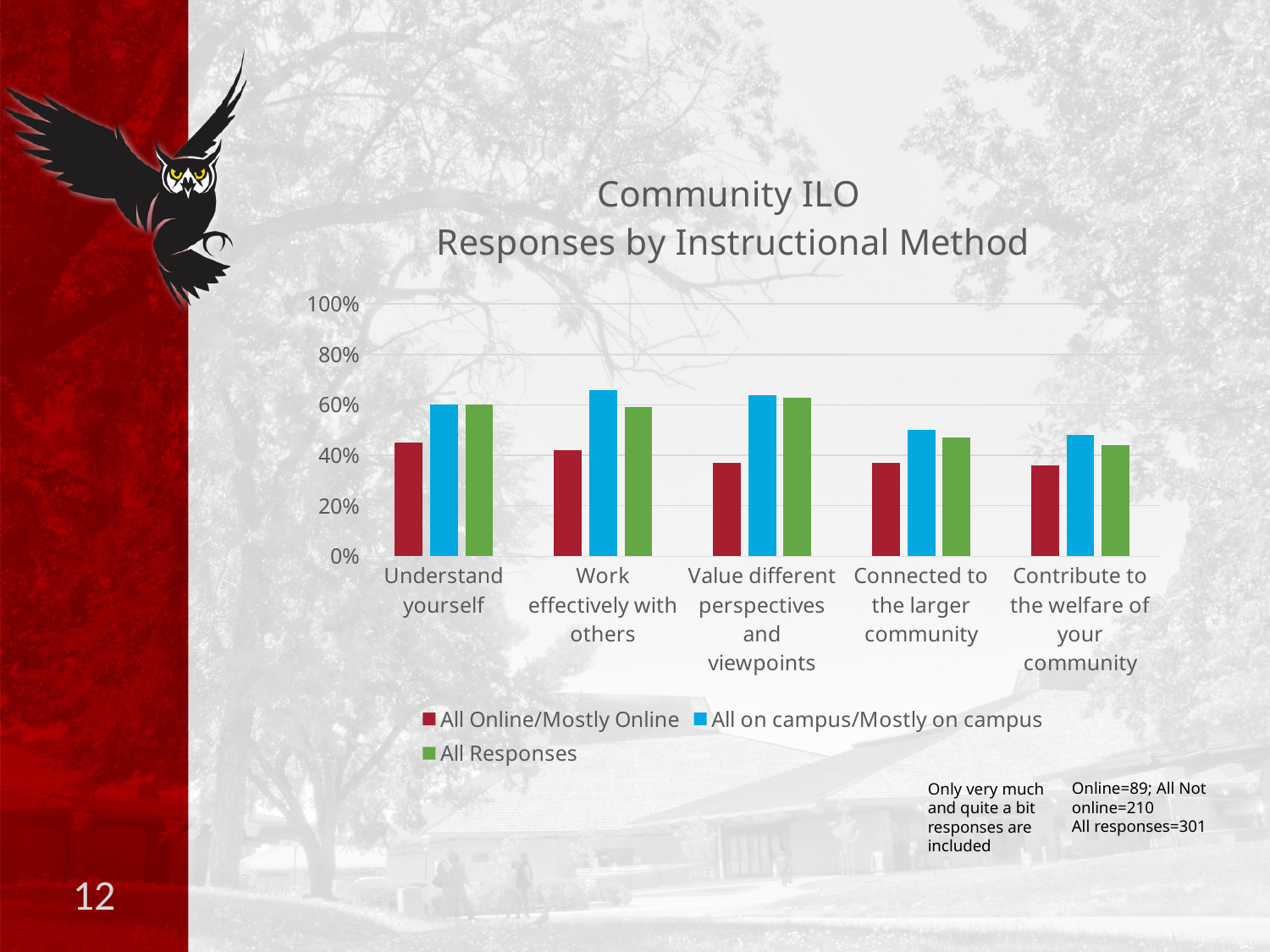
Is the All Online/Mostly Online value for Understand yourself greater or less than 40%? greater How many categories are shown on the x axis? 5 Is the All on campus/Mostly on campus value for Understand yourself greater or less than 80%? less Is the All on campus/Mostly on campus value for Work effectively with others greater or less than 60%? greater What kind of chart is shown on the slide? bar chart For Understand yourself, which is larger: All Online/Mostly Online or All on campus/Mostly on campus? All on campus/Mostly on campus How many series does the legend list? 3 For Connected to the larger community, which is larger: All Online/Mostly Online or All Responses? All Responses Do the All Online/Mostly Online values generally rise or fall from left to right across the categories? fall What colour represents the All Responses series? green